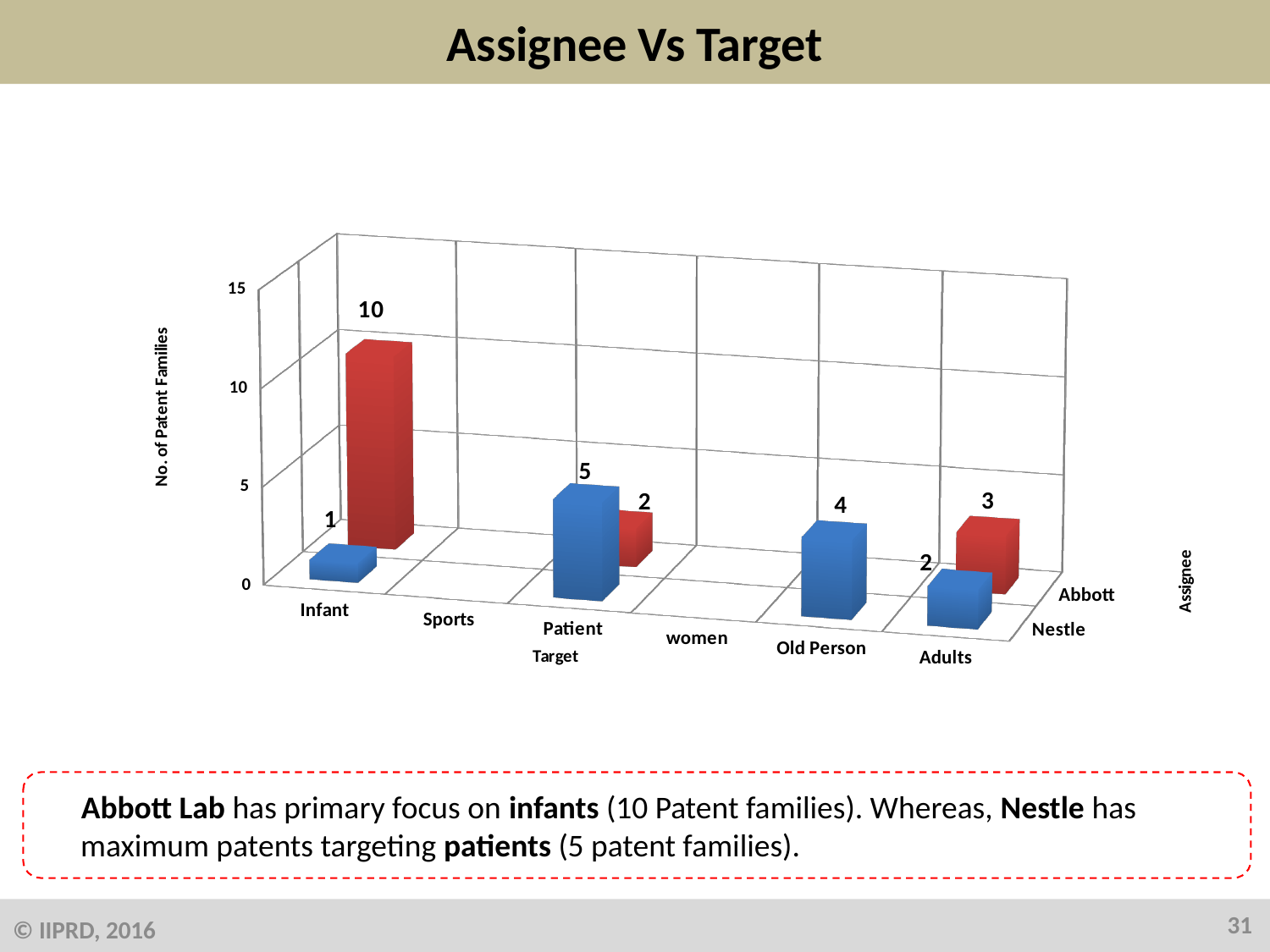
Which target category has the lowest number of patent families for Nestle? Infant What type of chart is shown on the slide? bar chart Which target category has the highest number of patent families for Abbott? Infant How many assignees (series) are shown in the chart? 2 What is the number of patent families for Nestle targeting Old Person? 4 What is the number of patent families for Nestle targeting Patient? 5 For the Patient target, which assignee has more patent families, Abbott or Nestle? Nestle What is the number of patent families for Abbott targeting Adults? 3 What is the number of patent families for Abbott targeting Infant? 10 What is the difference between Abbott's and Nestle's number of patent families for Infant? 9 How many target categories are shown on the x axis? 6 Is the value for Abbott targeting Infant greater or less than 5? greater